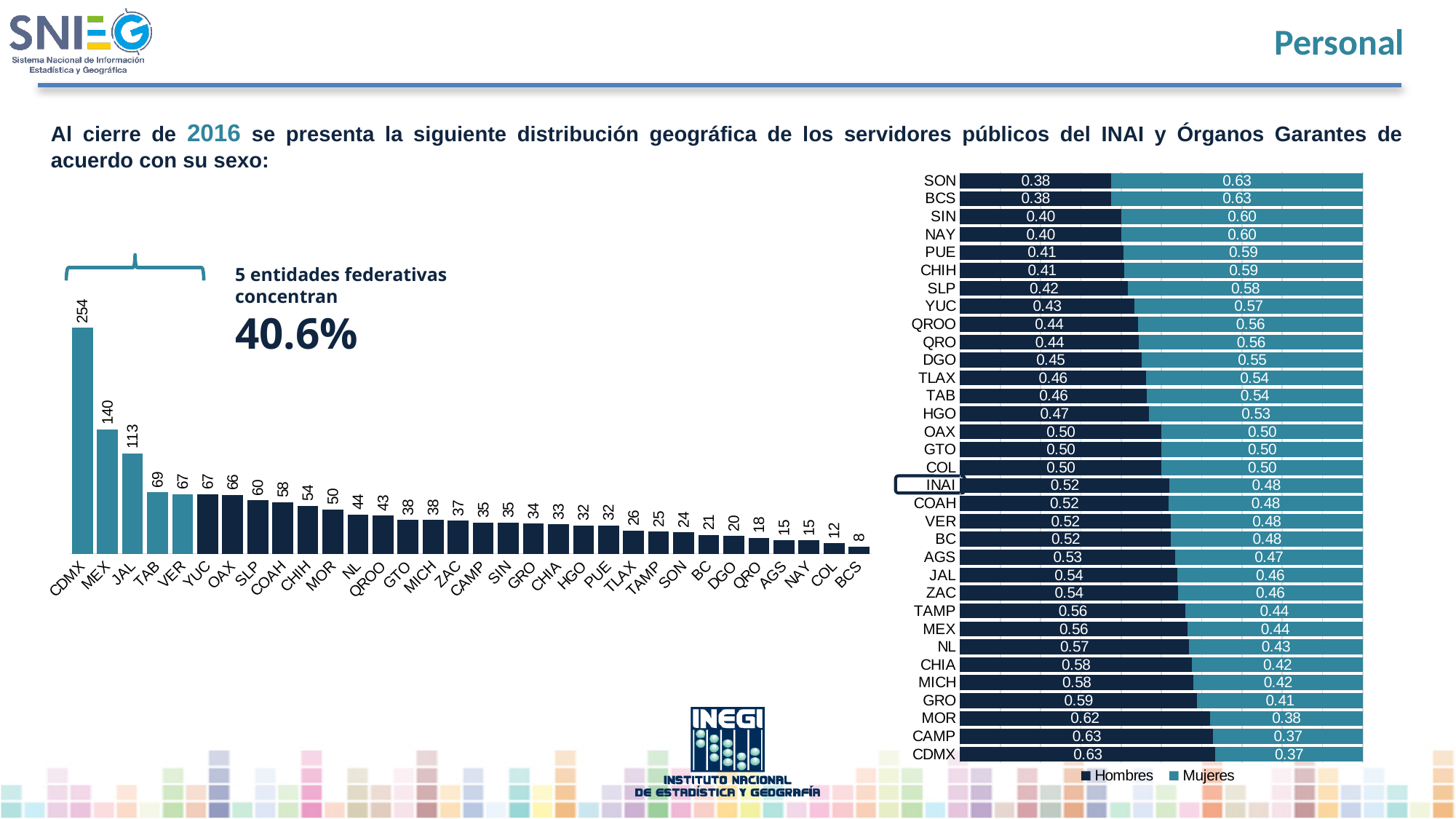
In the left bar chart, which category has the lowest value? BCS In the left bar chart, how many categories are shown on the x axis? 32 In the left bar chart, what is the value for CDMX? 254 In the right stacked bar chart, what is the Hombres value for INAI? 0.52 In the left bar chart, do the values rise or fall from left to right along the x axis? fall In the right stacked bar chart, which category has the highest Hombres value? CAMP and CDMX (both 0.63) In the left bar chart, what is the difference between the values for CDMX and MEX? 114 In the right stacked bar chart, how many series does the legend list? 2 In the right stacked bar chart, what are the two legend entries? Hombres, Mujeres What kind of chart is the chart on the right of the slide? stacked bar chart In the left bar chart, which is larger, the value for JAL or the value for TAB? JAL In the right stacked bar chart, what is the Mujeres value for SON? 0.63